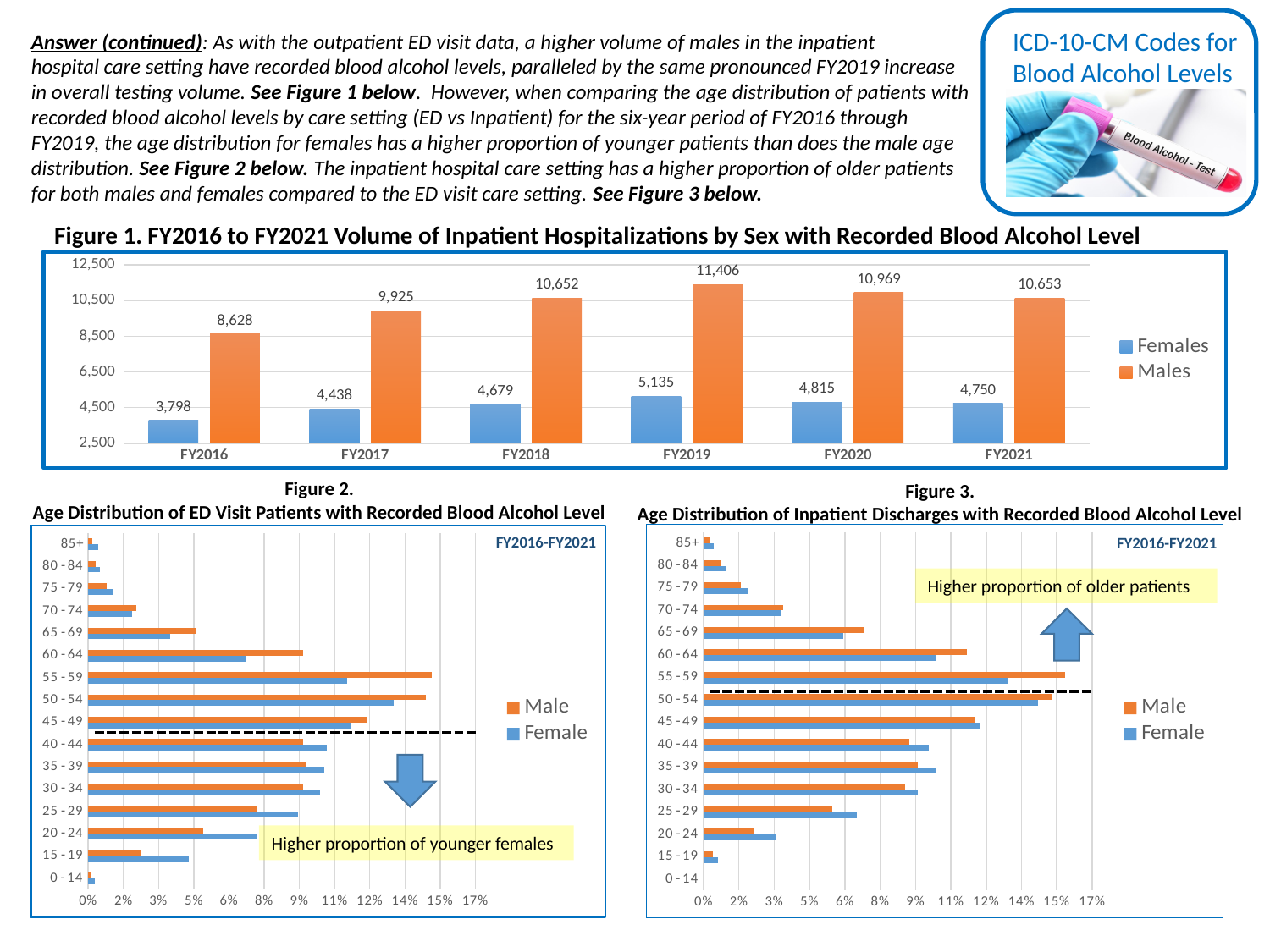
In Figure 1, how many fiscal years are shown on the x axis? 6 In Figure 3, how many age groups are shown on the vertical axis? 16 In Figure 1, which fiscal year has the highest value for Males? FY2019 In Figure 1, do the Females values rise or fall from FY2016 to FY2019? Rise In Figure 1, what is the value for Males in FY2019? 11,406 In Figure 1, what is the value for Females in FY2016? 3,798 In Figure 2, is the Male value for the 55 - 59 age group greater or less than 12%? greater In Figure 2, which is larger for the 20 - 24 age group, the Male value or the Female value? Female In Figure 1, what is the difference between the Males and Females values in FY2019? 6,271 In Figure 1, which fiscal year has the lowest value for Females? FY2016 What kind of chart is Figure 1? Bar chart In Figure 1, how many series does the legend list? 2